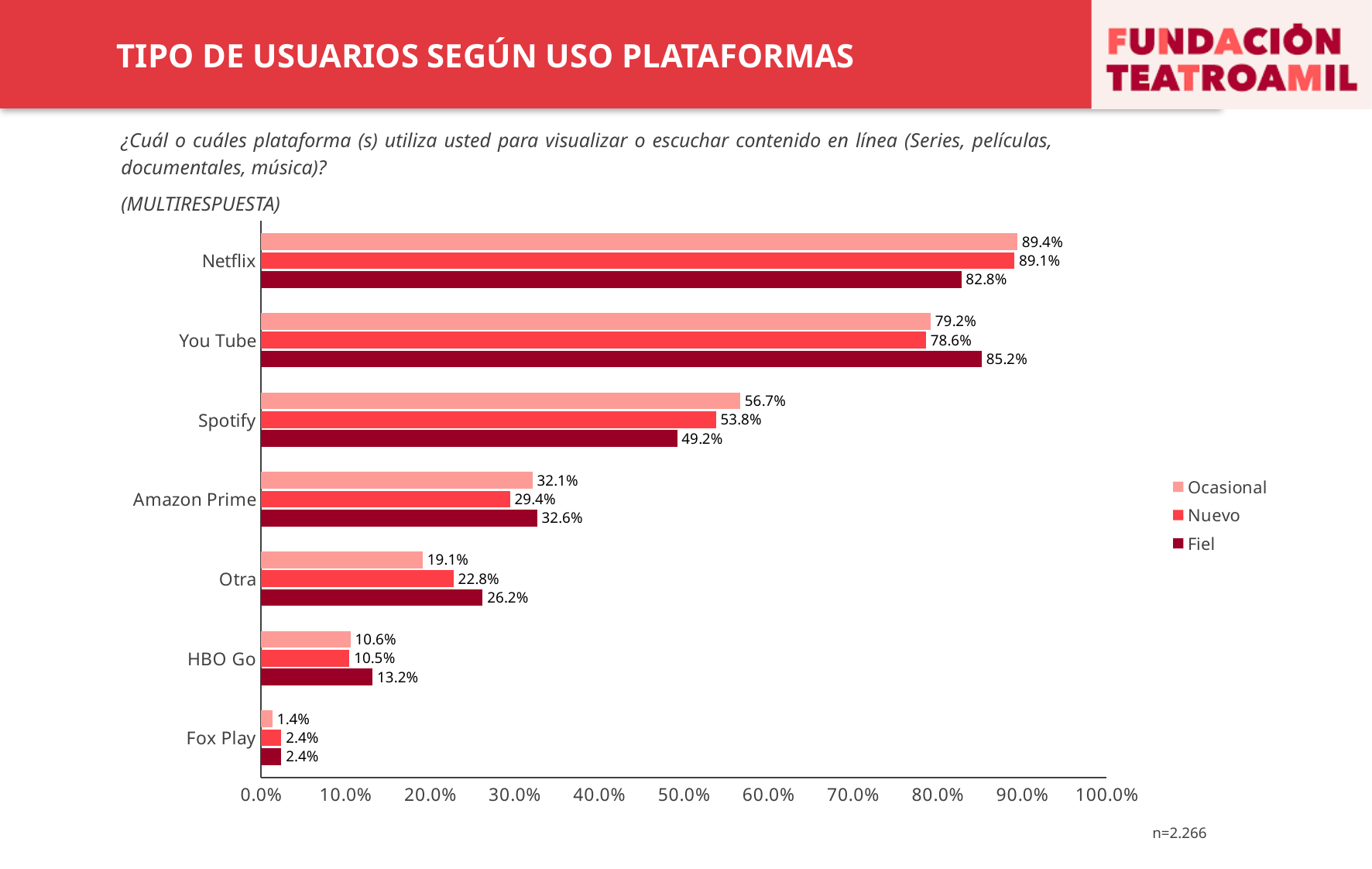
How many series does the legend list? 3 What is the Ocasional value for Netflix? 89.4% What is the Fiel value for You Tube? 85.2% What is the difference between the Fiel values for You Tube and Netflix? 2.4% What is the Nuevo value for Spotify? 53.8% What kind of chart is shown on the slide? Bar chart For Otra, which is larger: the Nuevo value or the Fiel value? Fiel What is the difference between the Ocasional and Fiel values for Spotify? 7.5% Which platform has the highest Fiel value? You Tube What are the three series named in the legend? Ocasional, Nuevo, Fiel Which platform has the lowest Ocasional value? Fox Play How many platforms are listed on the chart? 7